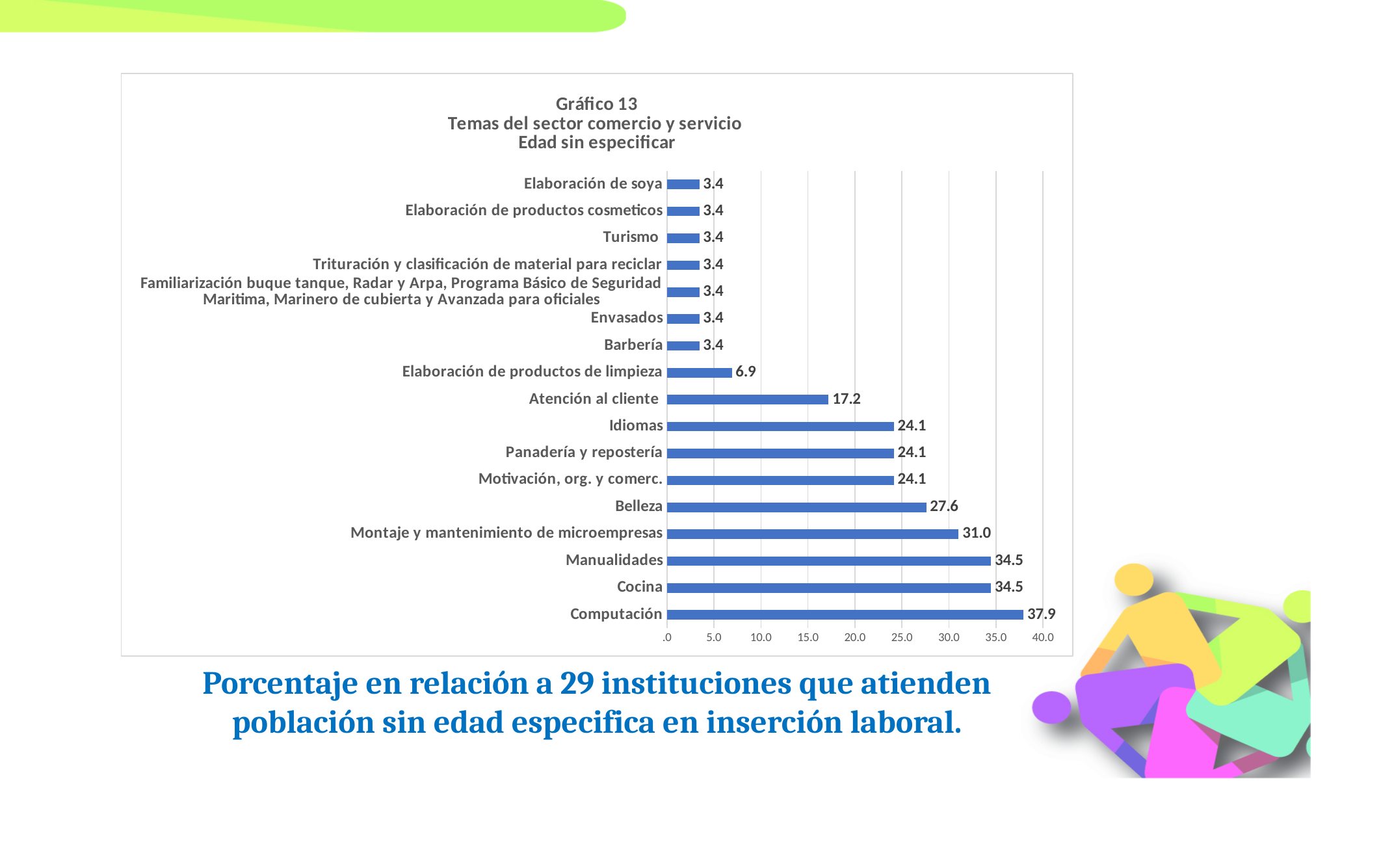
What is the value for Belleza? 27.6 Which is larger, the value for Belleza or the value for Panadería y repostería? Belleza Is the value for Manualidades greater or less than 30.0? greater What kind of chart is shown on the slide? Bar chart How many categories are shown in the chart? 17 What is the difference between the values for Computación and Cocina? 3.4 Which category has the highest value? Computación What is the value for Elaboración de productos de limpieza? 6.9 What is the value for Computación? 37.9 What is the number of the chart given in its title? Gráfico 13 What is the difference between the values for Montaje y mantenimiento de microempresas and Idiomas? 6.9 What is the value for Atención al cliente? 17.2